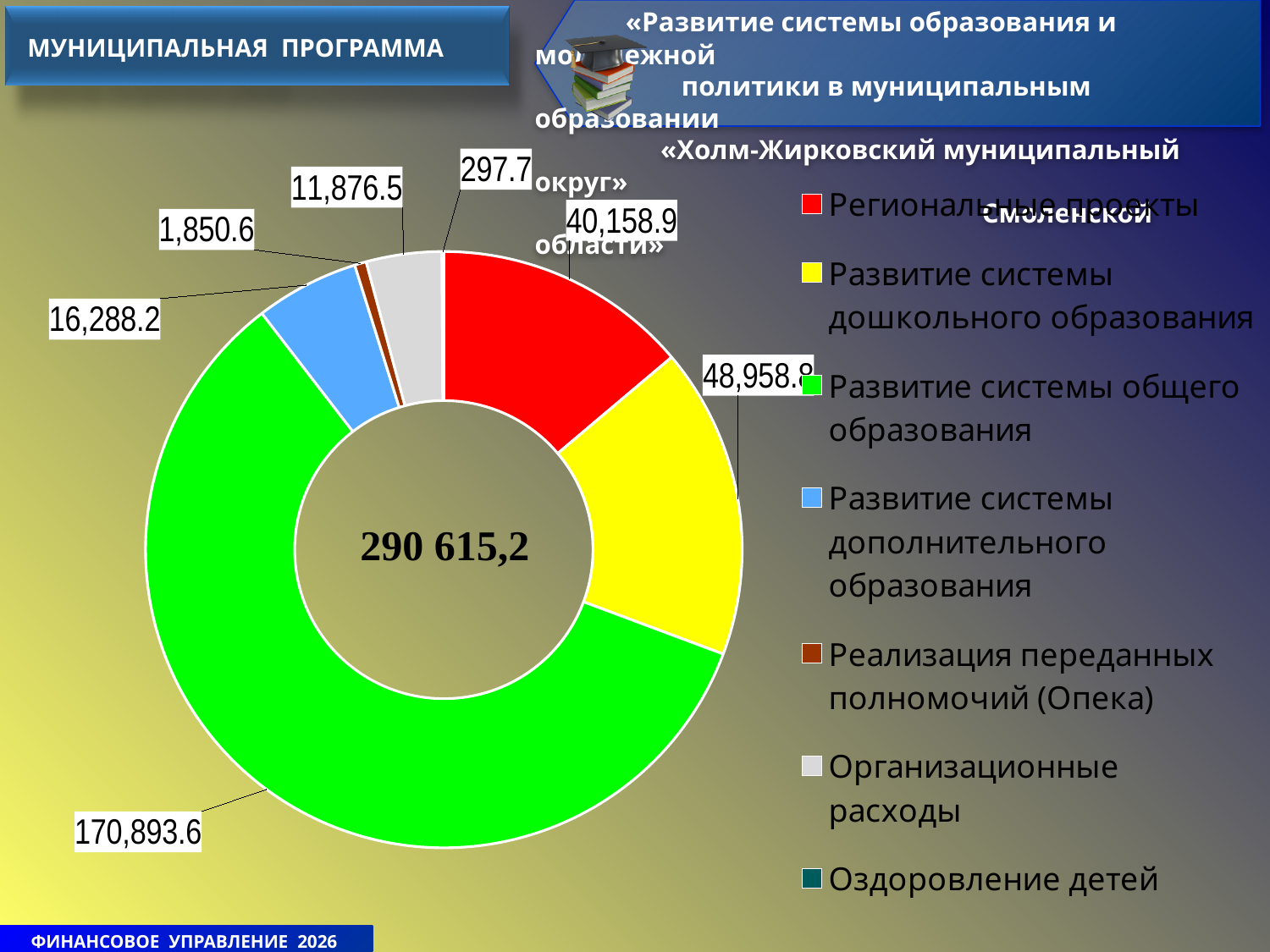
What is the value for «Оздоровление детей»? 297.7 Which category has the largest slice in the chart? Развитие системы общего образования What is the value for «Региональные проекты»? 40,158.9 What is the value for «Развитие системы дополнительного образования»? 16,288.2 Which is larger: «Региональные проекты» or «Развитие системы дошкольного образования»? Развитие системы дошкольного образования What is the value for «Реализация переданных полномочий (Опека)»? 1,850.6 What is the value for «Развитие системы общего образования»? 170,893.6 Which category has the smallest slice in the chart? Оздоровление детей What is the value for «Организационные расходы»? 11,876.5 What is the difference between the values for «Развитие системы дополнительного образования» and «Организационные расходы»? 4,411.7 What kind of chart is shown on the slide? doughnut (pie) chart How many categories does the legend of the chart list? 7